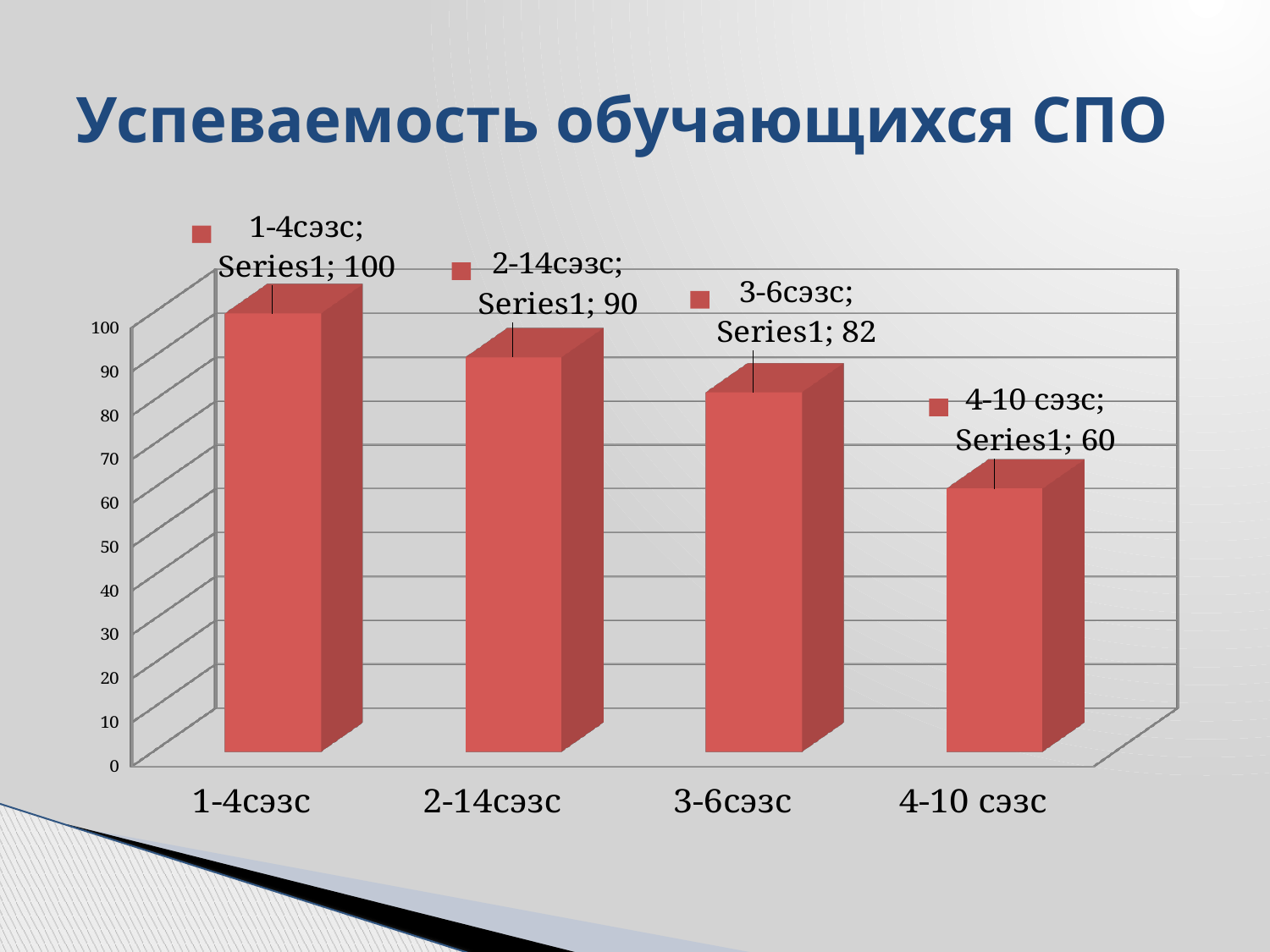
What is the value for 3-6сэзс? 82 Which is larger, the value for 2-14сэзс or the value for 3-6сэзс? 2-14сэзс What is the value for 2-14сэзс? 90 Which category has the lowest value? 4-10 сэзс How many categories are shown on the x axis? 4 What is the difference between the values for 2-14сэзс and 3-6сэзс? 8 What is the difference between the values for 1-4сэзс and 4-10 сэзс? 40 What is the value for 4-10 сэзс? 60 What kind of chart is shown on the slide? bar chart Which category has the highest value? 1-4сэзс Do the values rise or fall from left to right along the x axis? fall What is the value for 1-4сэзс? 100